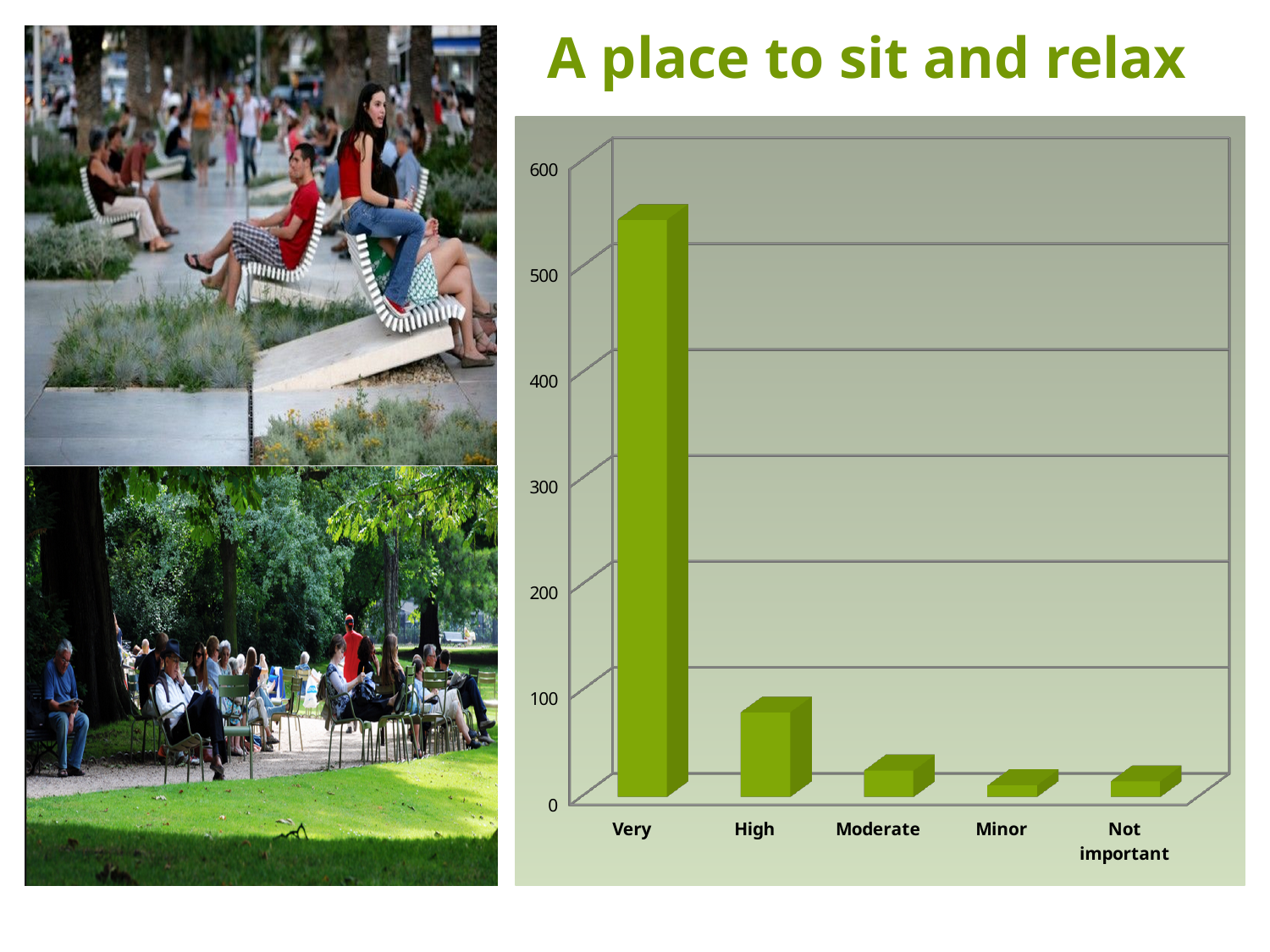
Is the value for Moderate greater or less than 100? less Which is larger, the value for Very or the value for High? Very Which is larger, the value for High or the value for Moderate? High What kind of chart is shown on the slide? bar chart Is the value for Very greater or less than 400? greater What colour are the bars in the chart? green What is the title shown above the chart? A place to sit and relax How many categories are shown on the x axis of the chart? 5 Which category has the highest bar in the chart? Very Do the values generally rise or fall moving from Very to Not important along the x axis? fall Is the value for Very greater or less than 500? greater